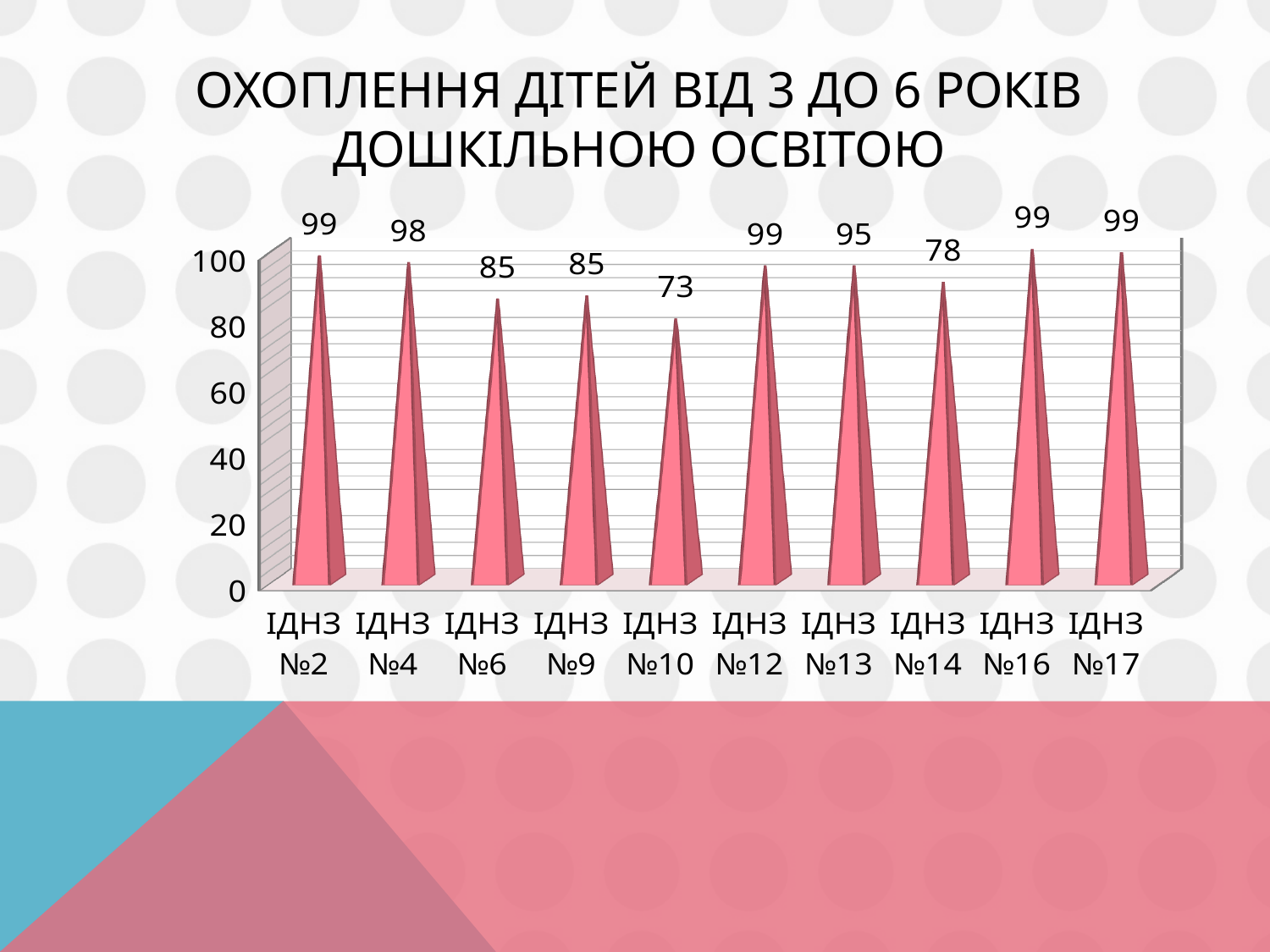
What is the value for ІДНЗ №10? 73 How many categories are shown on the x axis? 10 What is the title of the chart? ОХОПЛЕННЯ ДІТЕЙ ВІД 3 ДО 6 РОКІВ ДОШКІЛЬНОЮ ОСВІТОЮ Which category has the lowest value? ІДНЗ №10 What is the difference between the values for ІДНЗ №2 and ІДНЗ №10? 26 What is the value for ІДНЗ №14? 78 What is the value for ІДНЗ №4? 98 Is the value for ІДНЗ №10 greater or less than 80? less What is the value for ІДНЗ №13? 95 Which is larger, the value for ІДНЗ №6 or the value for ІДНЗ №14? ІДНЗ №6 What kind of chart is shown on the slide? bar chart What is the difference between the values for ІДНЗ №13 and ІДНЗ №14? 17